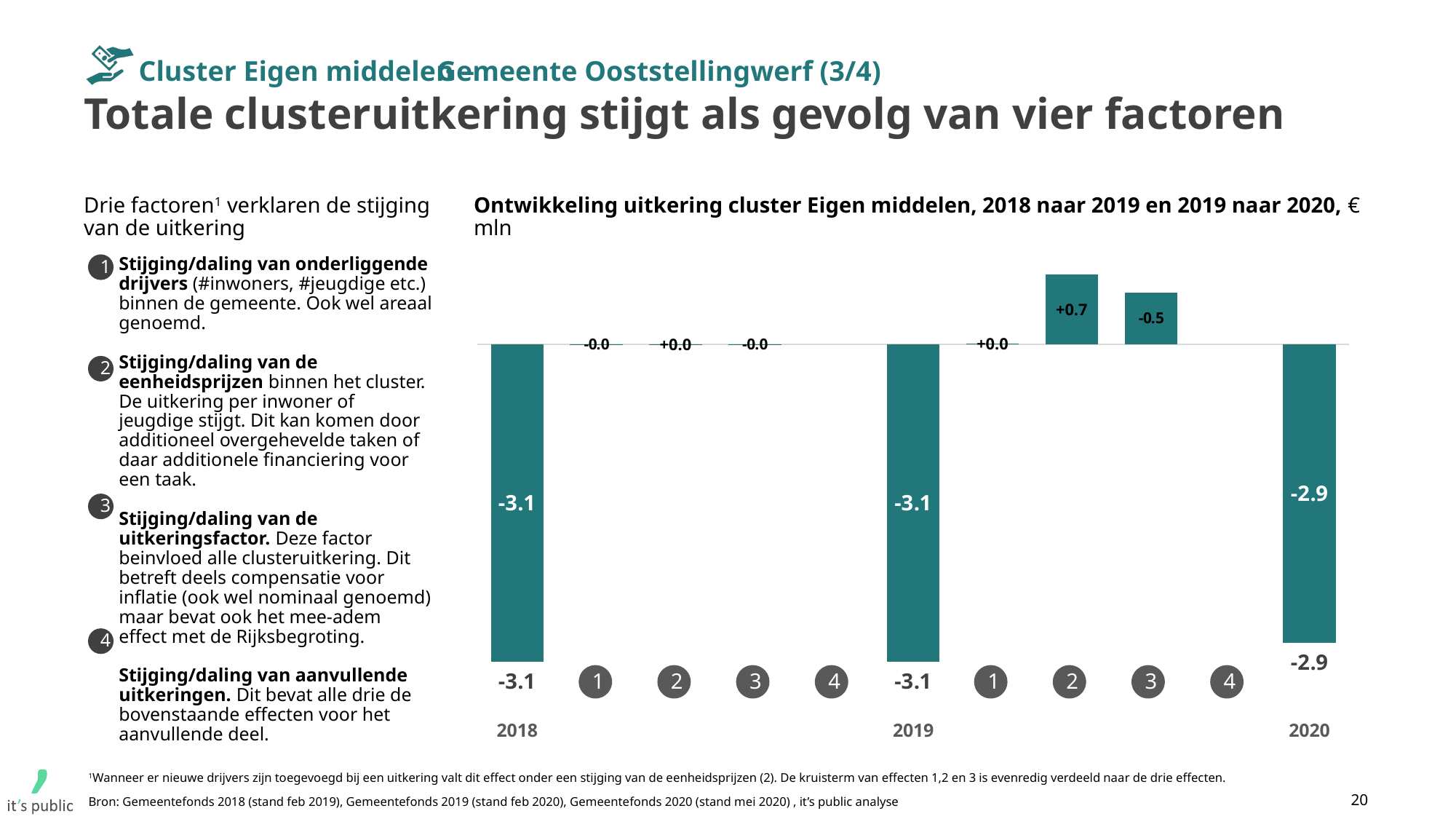
What is the difference between the 2020 value and the 2018 value in the chart? 0.2 What is the value of the 2018 bar in the chart? -3.1 What is the difference between the factor 2 value (+0.7) and the factor 3 value (-0.5) in the 2019 to 2020 step? 1.2 What type of chart is shown on the slide? Bar chart (waterfall) What is the value of the 2019 bar in the chart? -3.1 Which factor has the highest value in the 2019 to 2020 step of the chart? 2 Which factor has the lowest value in the 2019 to 2020 step of the chart? 3 How many year totals (2018, 2019, 2020) are shown as bars in the chart? 3 Which is larger, the value for 2019 or the value for 2020? 2020 What is the value labelled on factor 2 in the 2019 to 2020 step of the chart? +0.7 What is the value labelled on factor 3 in the 2019 to 2020 step of the chart? -0.5 What is the value of the 2020 bar in the chart? -2.9